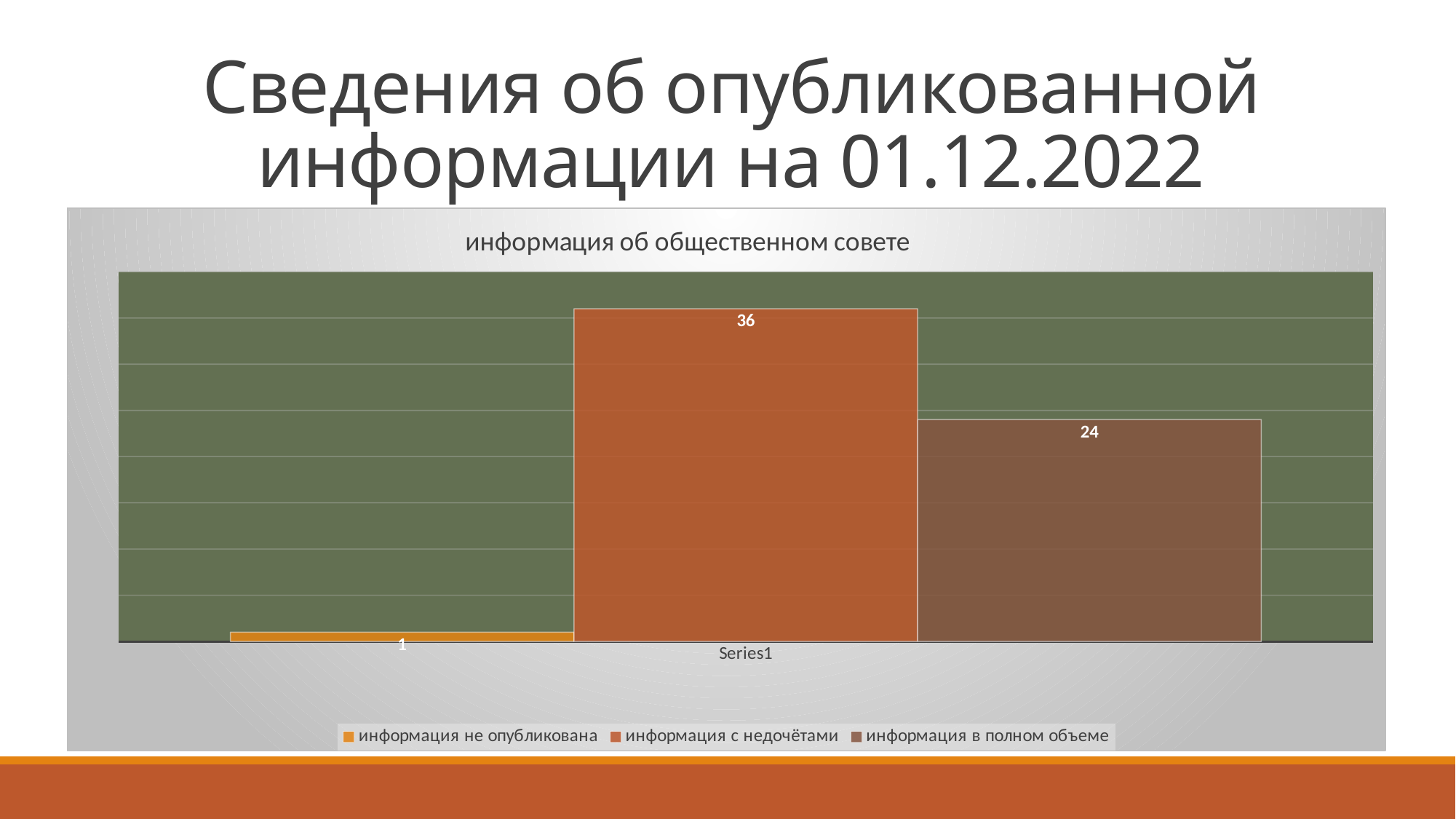
What is the difference between the values for "информация в полном объеме" and "информация не опубликована"? 23 What is the difference between the values for "информация с недочётами" and "информация в полном объеме"? 12 What is the category label shown on the x axis? Series1 What is the title of the chart? информация об общественном совете What kind of chart is shown on the slide? bar chart Which series has the highest value? информация с недочётами What is the value for "информация с недочётами"? 36 Which series has the lowest value? информация не опубликована What is the value for "информация не опубликована"? 1 Which is larger: the value for "информация с недочётами" or the value for "информация в полном объеме"? информация с недочётами What is the value for "информация в полном объеме"? 24 How many series does the legend list? 3